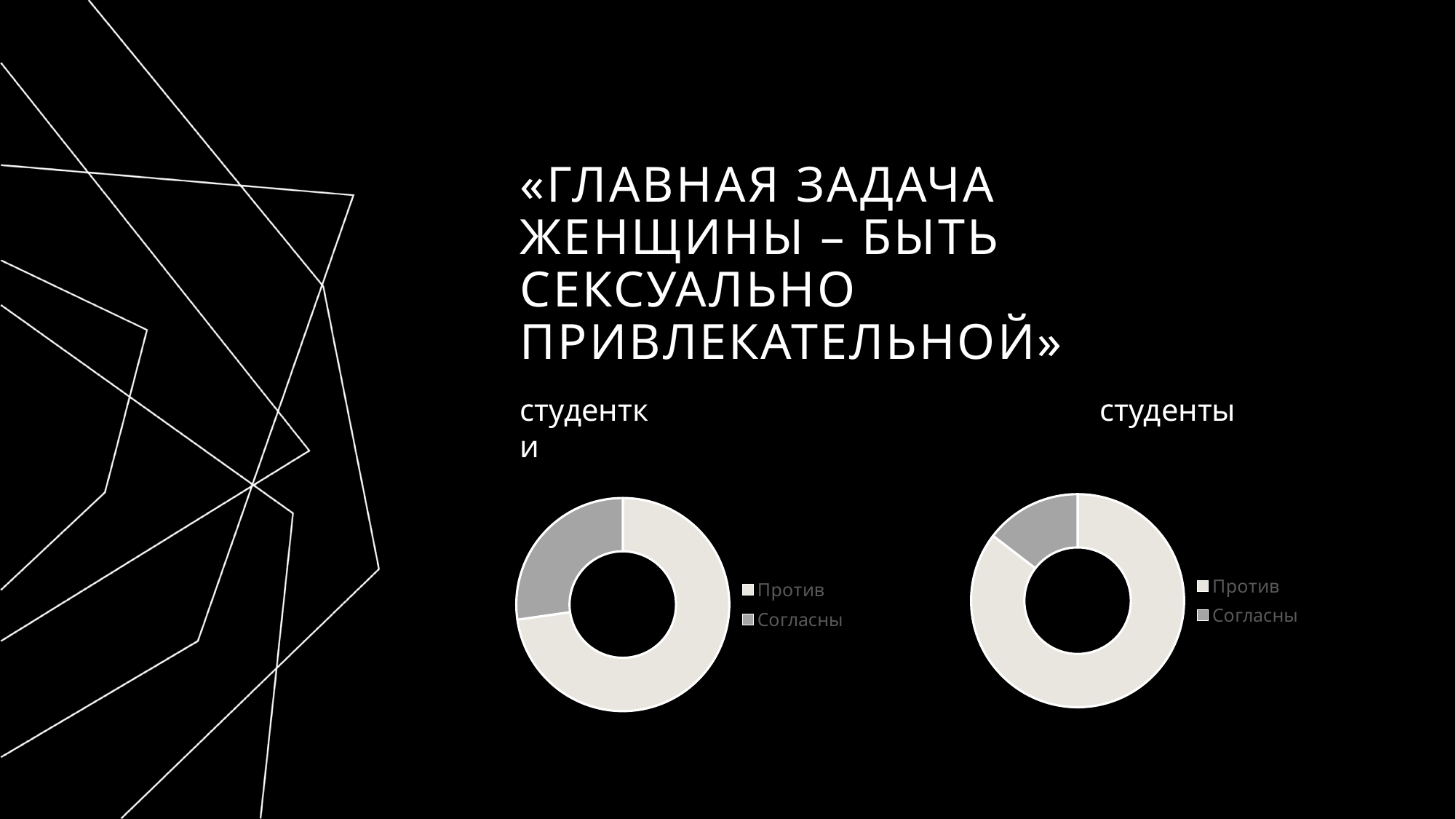
In the "студентки" chart, which category has the smallest slice? Согласны How many entries does the legend of the "студентки" chart list? 2 In the "студенты" chart, which category has the largest slice? Против In the "студенты" chart, which category has the smallest slice? Согласны Which chart has the larger Согласны slice, "студентки" or "студенты"? студентки What are the legend entries of the "студенты" chart? Против, Согласны How many categories does the "студенты" chart show? 2 What kind of chart is the "студенты" chart? doughnut chart In the "студентки" chart, which category has the largest slice? Против In the "студентки" chart, which slice is larger: Против or Согласны? Против How many charts are on the slide? 2 What kind of chart is the "студентки" chart? doughnut chart